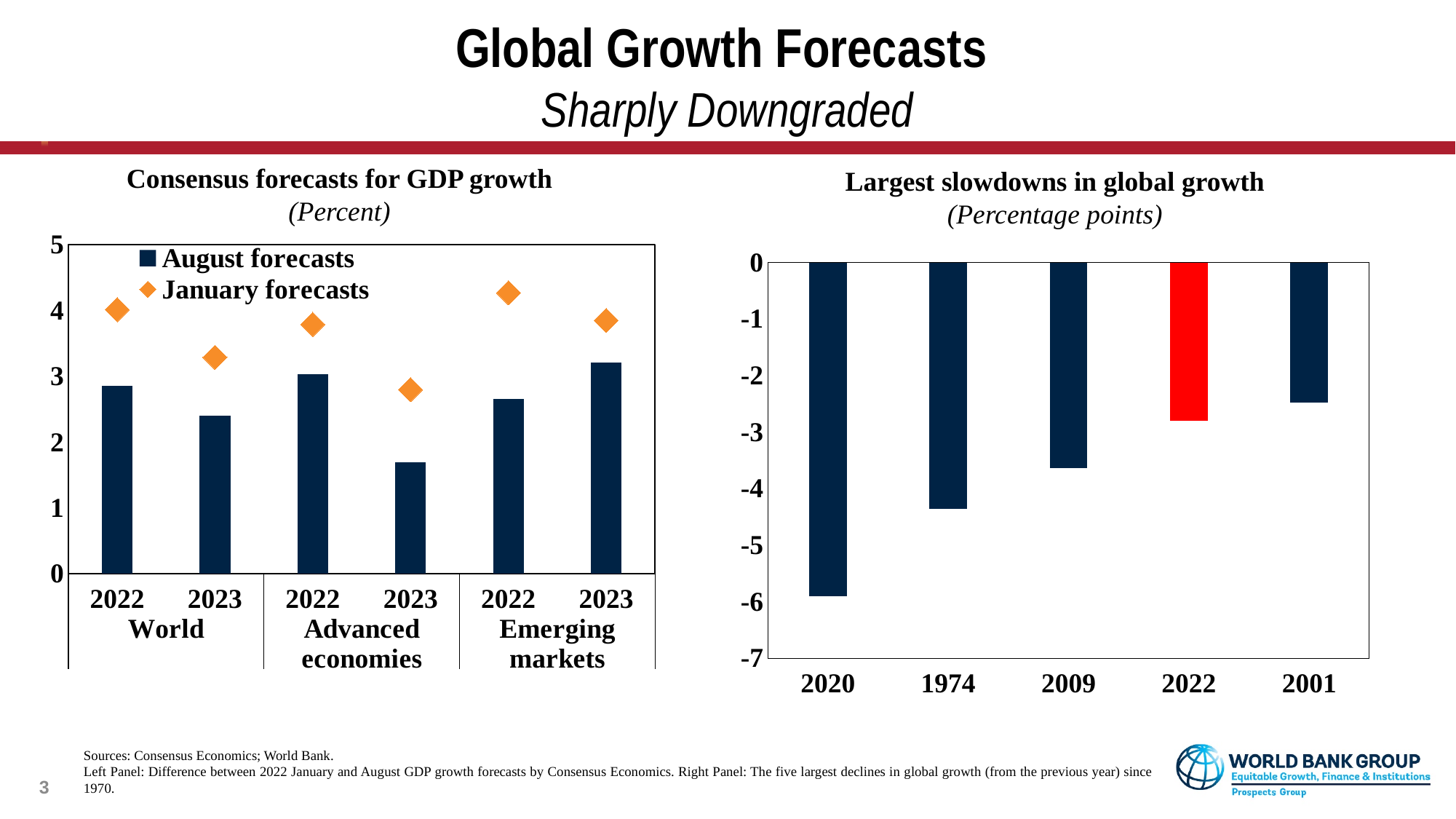
In the 'Consensus forecasts for GDP growth' chart, which series is shown with orange diamond markers? January forecasts In the 'Consensus forecasts for GDP growth' chart, is the August forecast for Advanced economies in 2023 greater or less than 2? less In the 'Consensus forecasts for GDP growth' chart, is the January forecast for Emerging markets in 2022 greater or less than 4? greater In the 'Largest slowdowns in global growth' chart, which year shows the largest slowdown? 2020 In the 'Consensus forecasts for GDP growth' chart, how many series does the legend list? 2 In the 'Consensus forecasts for GDP growth' chart, what kind of chart is used for the August forecasts? bar chart In the 'Largest slowdowns in global growth' chart, is the value for 1974 greater or less than -4? less In the 'Largest slowdowns in global growth' chart, which year shows the smallest slowdown? 2001 In the 'Consensus forecasts for GDP growth' chart, which August forecast bar is the lowest? Advanced economies 2023 In the 'Largest slowdowns in global growth' chart, how many years are shown on the x axis? 5 In the 'Consensus forecasts for GDP growth' chart, for World 2022, which is larger: the August forecast or the January forecast? January forecast In the 'Largest slowdowns in global growth' chart, which year's bar is coloured red? 2022